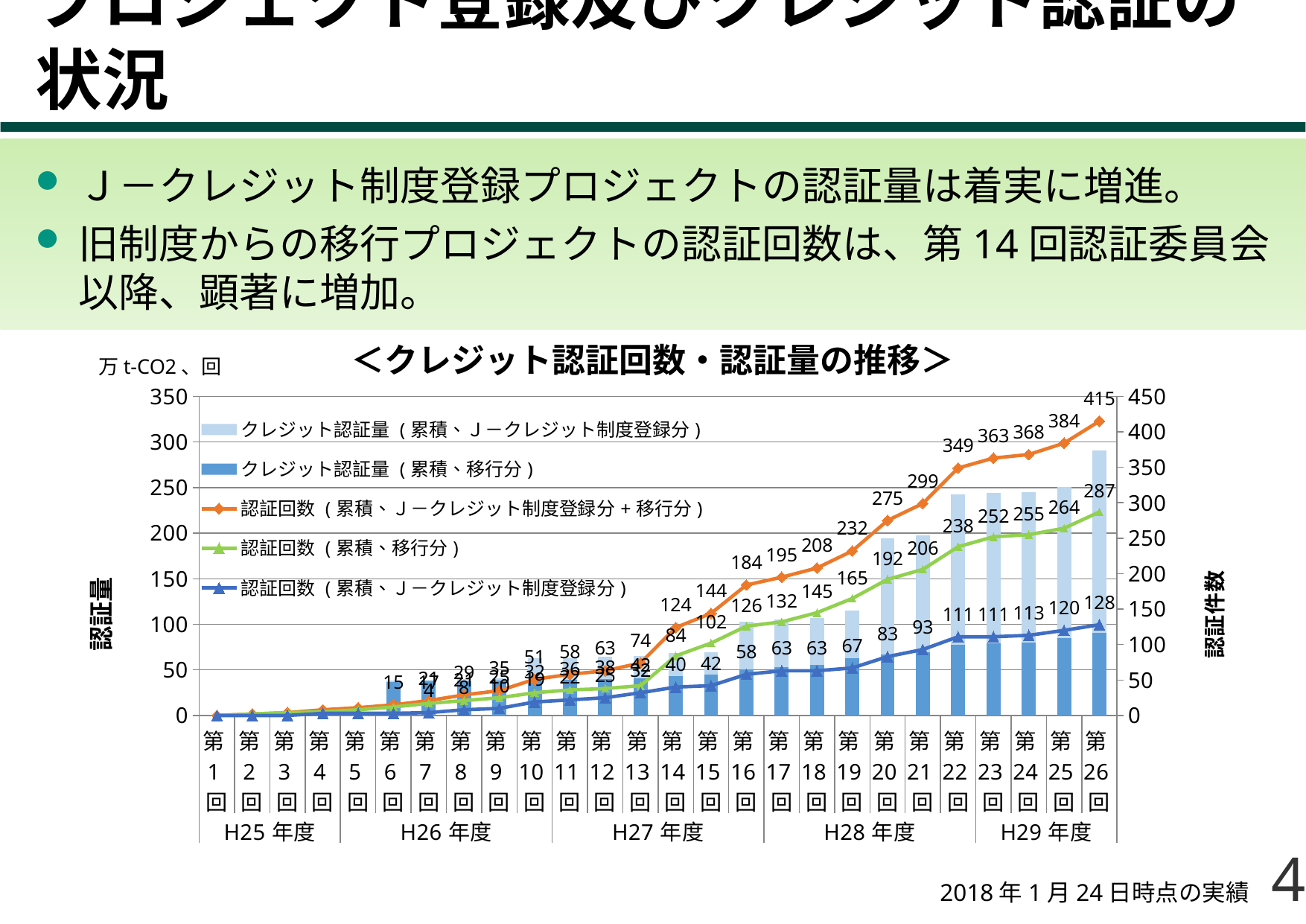
How many 回 (committee rounds) are shown along the x axis? 26 What is the difference between 認証回数（累積、移行分） at 第26回 and at 第25回? 23 What kind of chart is shown on the slide? A combination of a stacked bar chart and line chart How many series does the legend list? 5 What is the value of 認証回数（累積、Ｊ－クレジット制度登録分） at 第20回? 83 Do the 認証回数（累積、Ｊ－クレジット制度登録分＋移行分） values rise or fall from 第1回 to 第26回? rise What is the value of 認証回数（累積、Ｊ－クレジット制度登録分＋移行分） at 第14回? 124 What is the value of 認証回数（累積、移行分） at 第22回? 238 At 第19回, which is larger: 認証回数（累積、移行分） or 認証回数（累積、Ｊ－クレジット制度登録分）? 認証回数（累積、移行分） Is the total height of the stacked bar at 第26回 greater or less than 250 on the left axis? greater At which 回 does 認証回数（累積、Ｊ－クレジット制度登録分＋移行分） reach its highest value? 第26回 What is the value of 認証回数（累積、Ｊ－クレジット制度登録分＋移行分） at 第26回? 415